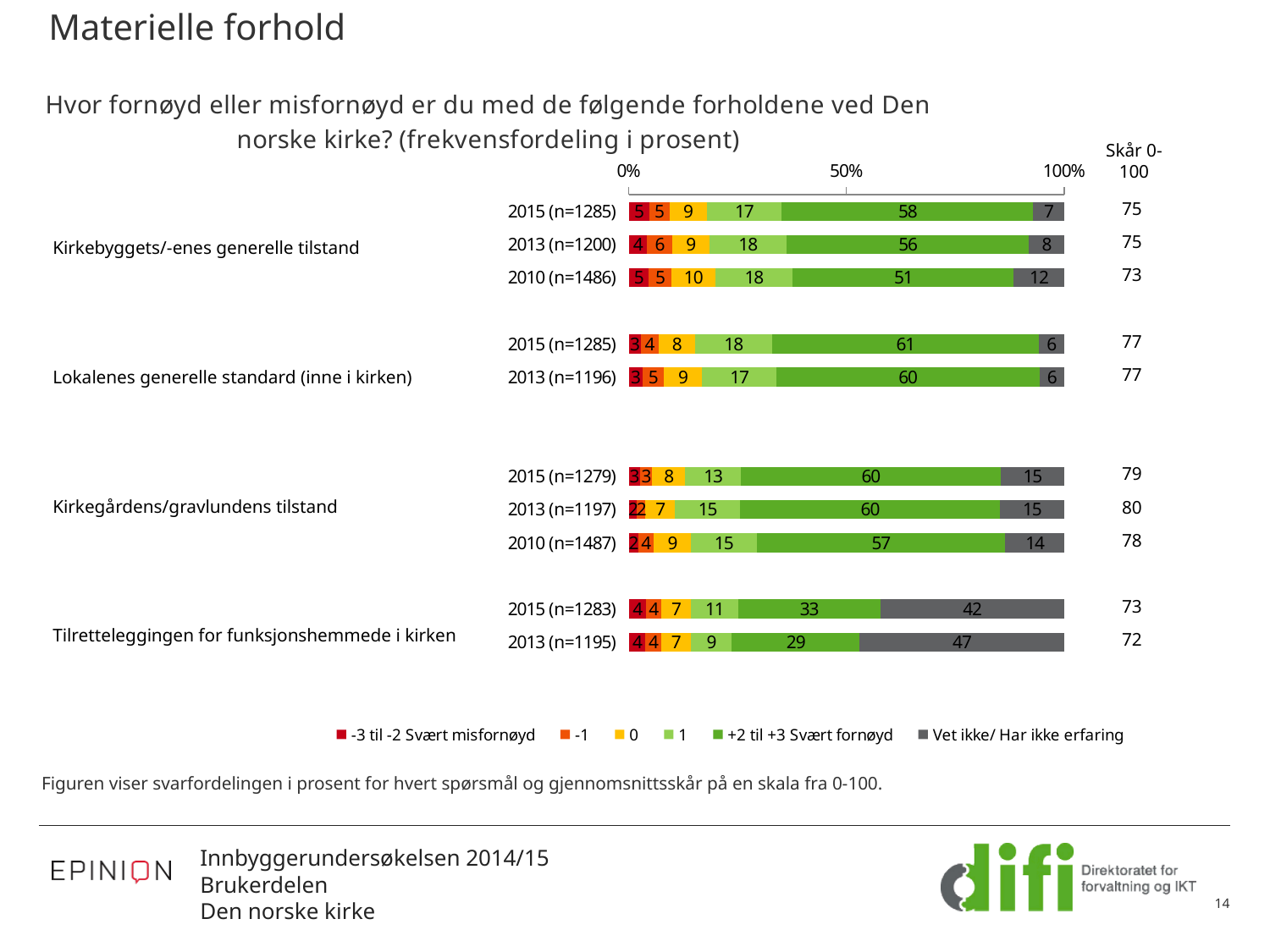
What percentage answered "Vet ikke/ Har ikke erfaring" for Tilretteleggingen for funksjonshemmede i kirken in 2013 (n=1195)? 47 How many bars are plotted in the chart? 10 What is the Skår 0-100 value for Kirkegårdens/gravlundens tilstand in 2013 (n=1197)? 80 How many series does the legend list? 6 What percentage answered "1" for Kirkegårdens/gravlundens tilstand in 2010 (n=1487)? 15 What percentage answered "0" for Lokalenes generelle standard (inne i kirken) in 2013 (n=1196)? 9 For Kirkebyggets/-enes generelle tilstand, which year has the larger "+2 til +3 Svært fornøyd" share, 2015 or 2010? 2015 What kind of chart is shown on the slide? Stacked bar chart What is the difference in the "Vet ikke/ Har ikke erfaring" share for Tilretteleggingen for funksjonshemmede i kirken between 2013 and 2015? 5 What percentage of respondents answered "+2 til +3 Svært fornøyd" for Kirkebyggets/-enes generelle tilstand in 2015 (n=1285)? 58 For Kirkebyggets/-enes generelle tilstand, does the "Vet ikke/ Har ikke erfaring" share rise or fall from 2010 to 2015? Fall Which bar has the highest "Vet ikke/ Har ikke erfaring" share? Tilretteleggingen for funksjonshemmede i kirken, 2013 (n=1195)